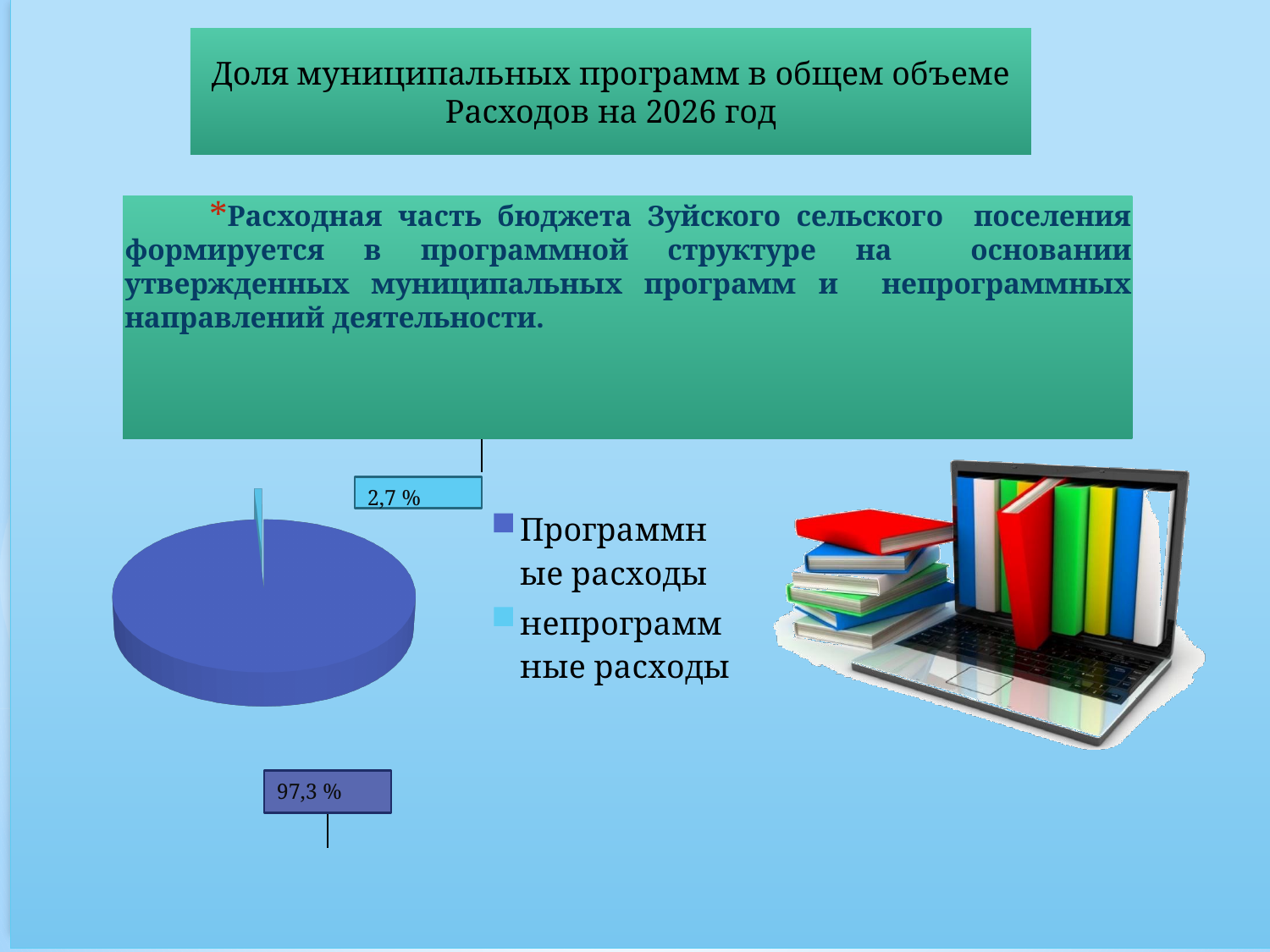
What is the title of the slide containing the pie chart? Доля муниципальных программ в общем объеме Расходов на 2026 год How many slices does the pie chart have? 2 What kind of chart is shown on the slide? pie chart What colour is the slice for непрограммные расходы? light blue What share of expenditures is labelled for Программные расходы? 97,3 % What share of expenditures is labelled for непрограммные расходы? 2,7 % Which is larger: the share of Программные расходы or непрограммные расходы? Программные расходы How many categories does the legend list? 2 Which category has the smallest slice of the pie? непрограммные расходы Which category has the largest slice of the pie? Программные расходы What is the difference between the shares of Программные расходы and непрограммные расходы? 94,6 %